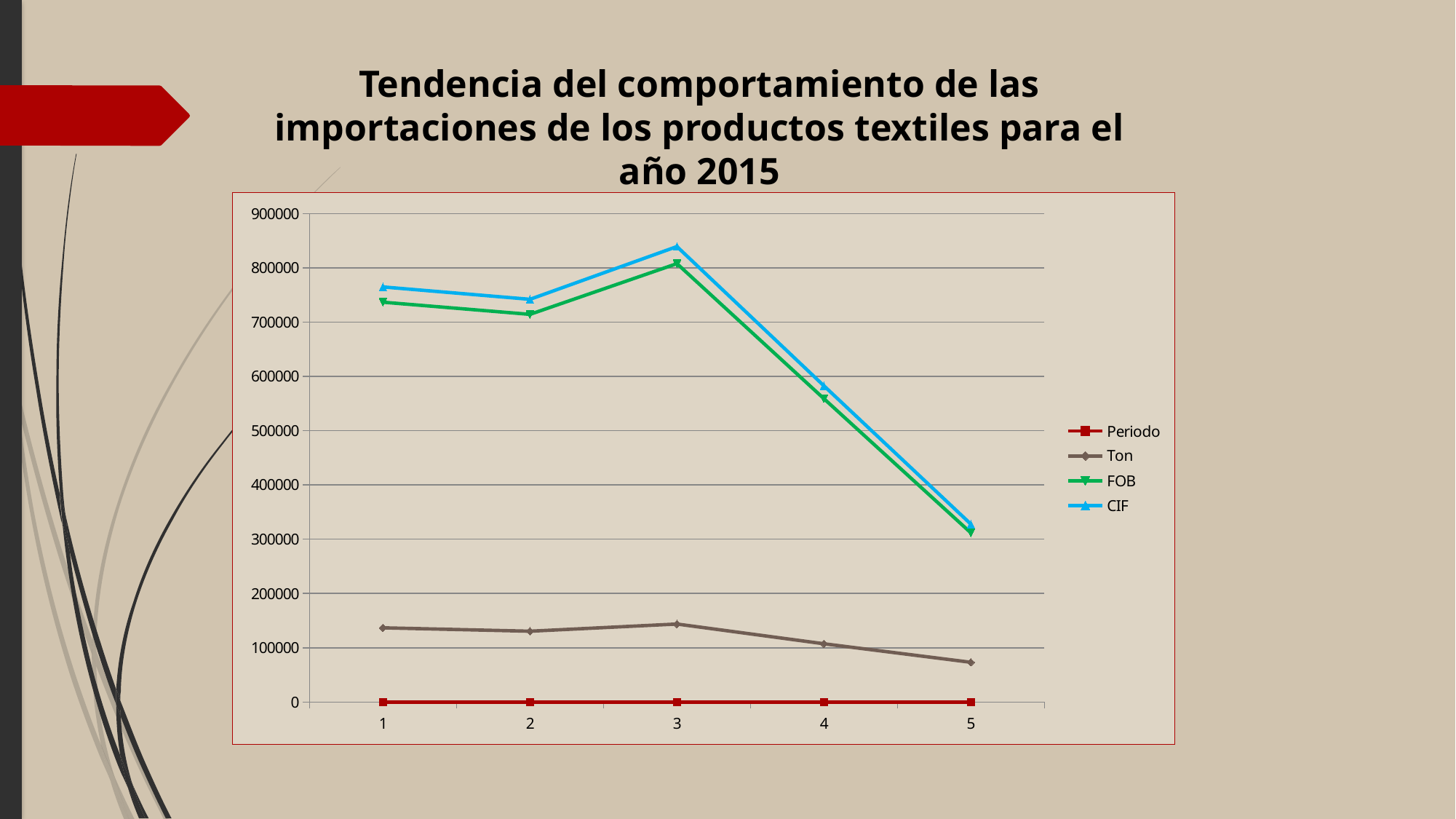
Do the CIF values rise or fall from point 3 to point 5? fall What kind of chart is shown on the slide? line chart Is the value for CIF at point 3 greater or less than 800000? greater How many series does the legend list? 4 Which series is drawn in green? FOB How many points are plotted along the x axis for each series? 5 At which x-axis point does the FOB series reach its lowest value? 5 Is the value for FOB at point 5 greater or less than 400000? less Is the value for Ton at point 5 greater or less than 100000? less Which is larger: the Ton value at point 1 or the Ton value at point 5? point 1 At which x-axis point does the CIF series reach its highest value? 3